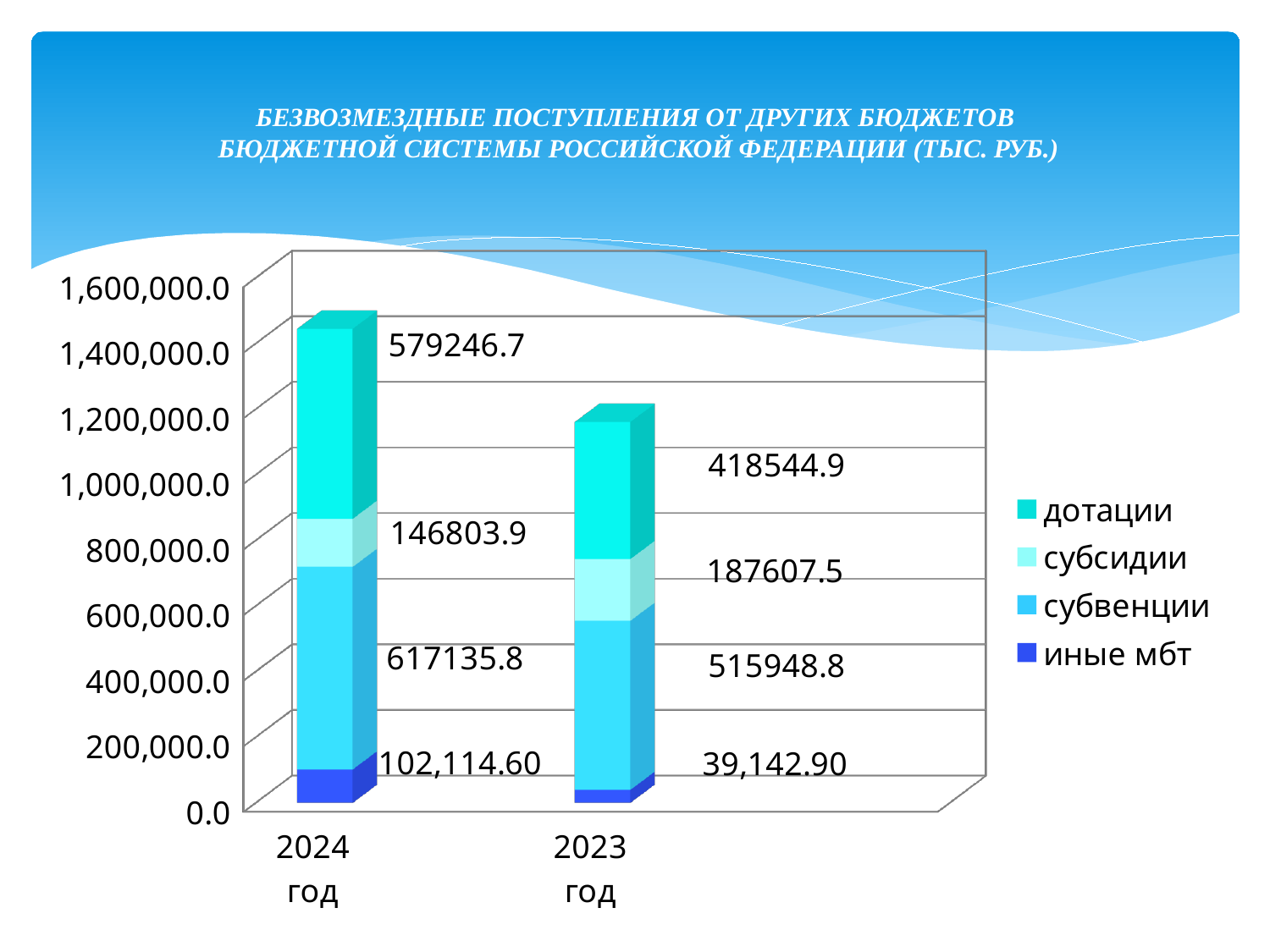
Which year has the larger value for дотации, 2024 год or 2023 год? 2024 год What is the difference between the субвенции values for 2024 год and 2023 год? 101187.0 What is the value of субвенции for 2023 год? 515948.8 How many series does the legend list? 4 What is the difference between the дотации values for 2024 год and 2023 год? 160701.8 What is the value of иные мбт for 2024 год? 102,114.60 How many categories (years) are shown on the x axis? 2 What is the total of the stacked bar for 2023 год? 1161244.1 Is the total of the stacked bar for 2024 год greater or less than 1,400,000.0? greater What is the value of субсидии for 2023 год? 187607.5 What is the value of дотации for 2024 год? 579246.7 What type of chart is shown on the slide? stacked bar chart